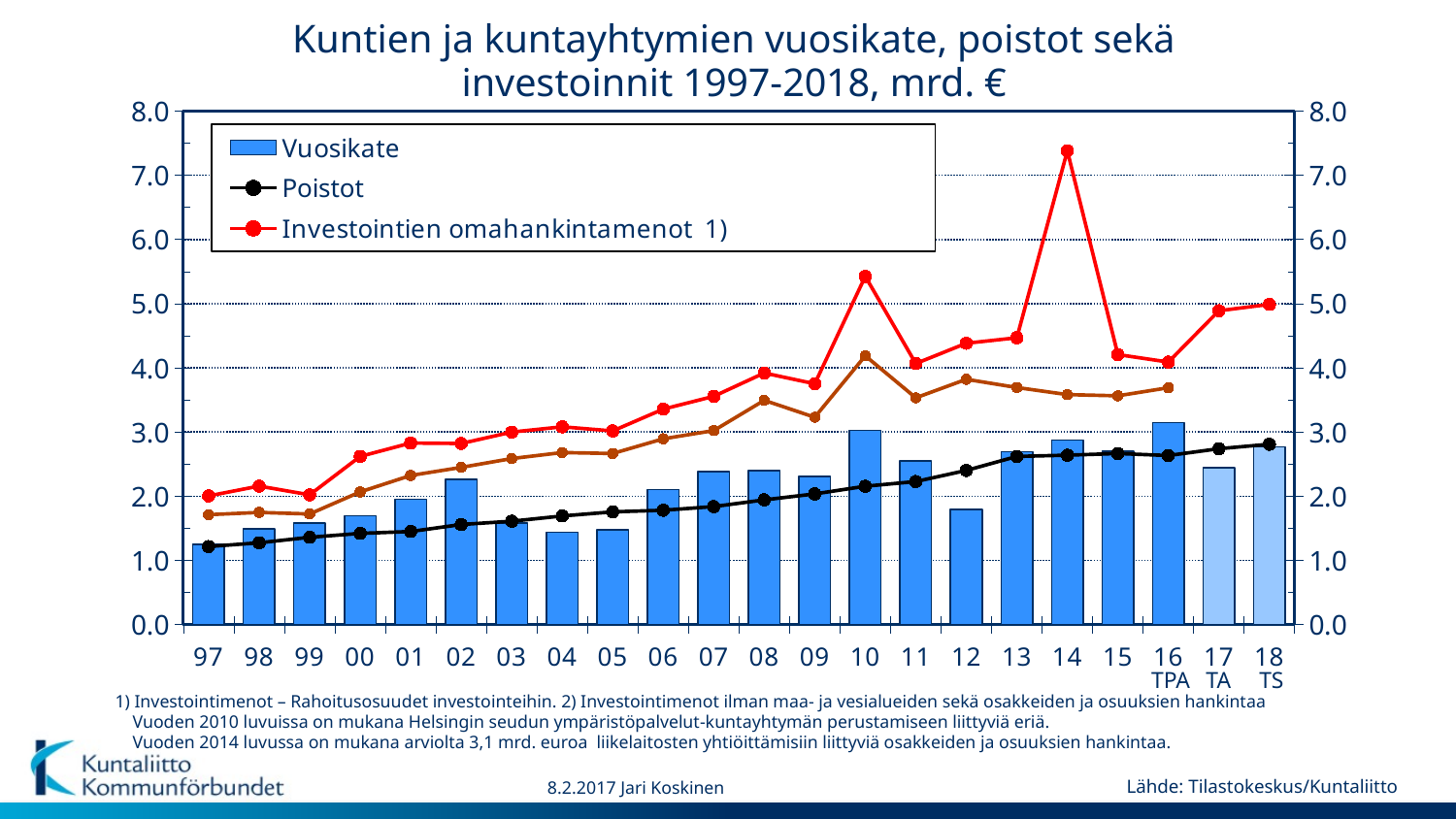
How many years are shown on the x axis? 22 What is the title of the chart? Kuntien ja kuntayhtymien vuosikate, poistot sekä investoinnit 1997-2018, mrd. € Is the Vuosikate value in 12 greater or less than 2.0? less Does the Poistot line generally rise or fall from 97 to 18? rise Is the Poistot value in 18 greater or less than 3.0? less What kind of chart is used to show the Vuosikate series? bar chart In which year is the Vuosikate bar the lowest? 97 What colour are the Vuosikate bars? blue Which year has the larger Vuosikate bar, 12 or 13? 13 Is the value of Investointien omahankintamenot in 14 greater or less than 7.0? greater How many series does the legend list? 3 In which year does the Investointien omahankintamenot line reach its highest value? 14